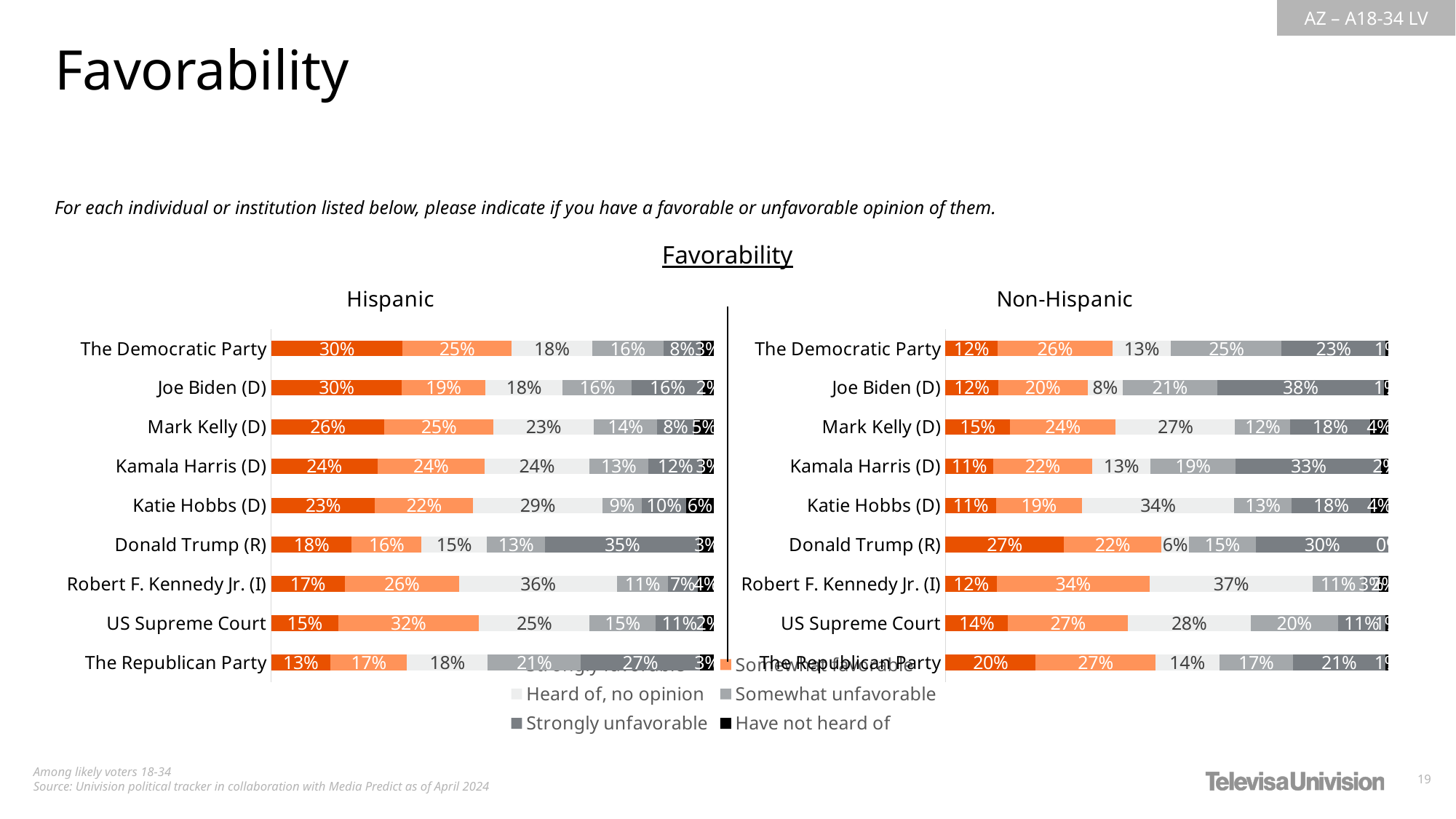
In the Hispanic chart, what is the difference in percentage points between the strongly unfavorable values for Donald Trump (R) and The Republican Party? 8 percentage points In the Non-Hispanic chart, which individual or institution has the lowest 'Heard of, no opinion' percentage? Donald Trump (R) In the Non-Hispanic chart, which individual or institution has the highest strongly favorable percentage? Donald Trump (R) How many individuals or institutions are listed in the Hispanic chart? 9 In the Non-Hispanic chart, what is the somewhat favorable value for the US Supreme Court? 27% In the Hispanic chart, what percentage of respondents are strongly favorable toward Mark Kelly (D)? 26% How many series does the legend list for the favorability charts? 6 What type of chart is used to show favorability for the Hispanic and Non-Hispanic groups? Stacked bar chart In the Non-Hispanic chart, what percentage of respondents are strongly unfavorable toward Joe Biden (D)? 38% Is the 'Heard of, no opinion' value for Katie Hobbs (D) larger in the Hispanic chart or the Non-Hispanic chart? Non-Hispanic In the Hispanic chart, what is the 'Heard of, no opinion' value for Robert F. Kennedy Jr. (I)? 36% In the Hispanic chart, which individual or institution has the highest strongly unfavorable percentage? Donald Trump (R)